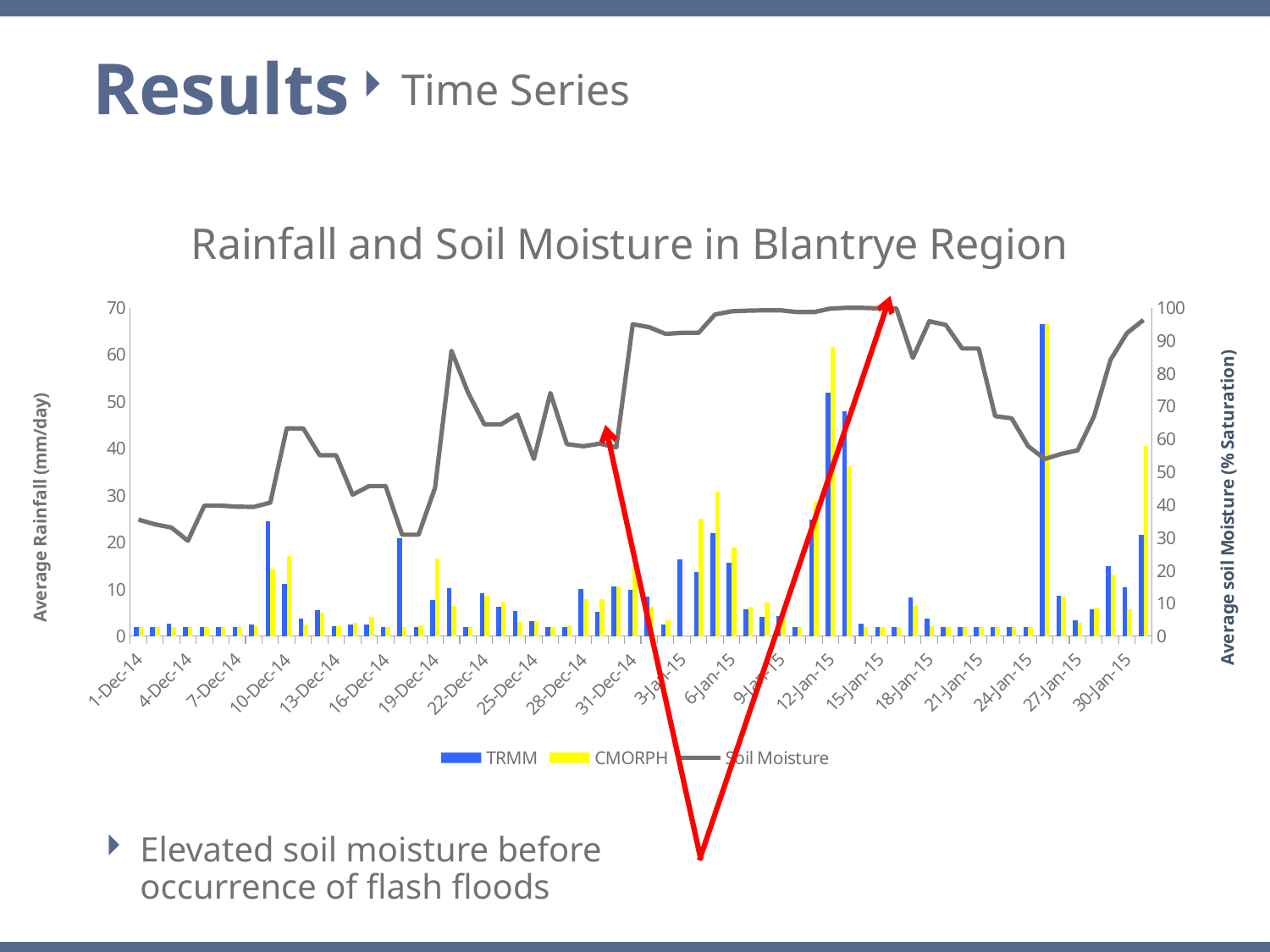
Is the TRMM value on 10-Dec-14 greater or less than 20? less On which date does the TRMM series reach its highest value? 25-Jan-15 Is the CMORPH value on 12-Jan-15 greater or less than 50? greater On 10-Dec-14, which is larger, the TRMM value or the CMORPH value? CMORPH Is the Soil Moisture value on 12-Jan-15 greater or less than 90? greater How many series does the chart's legend list? 3 What kind of chart is shown on the slide? Combined bar and line chart Which series is drawn as a line rather than bars? Soil Moisture What is the title of the chart? Rainfall and Soil Moisture in Blantrye Region On 12-Jan-15, which is larger, the TRMM value or the CMORPH value? CMORPH Does the Soil Moisture line rise or fall overall from 1-Dec-14 to 15-Jan-15? rise On which labelled date is the Soil Moisture line at its lowest? 4-Dec-14